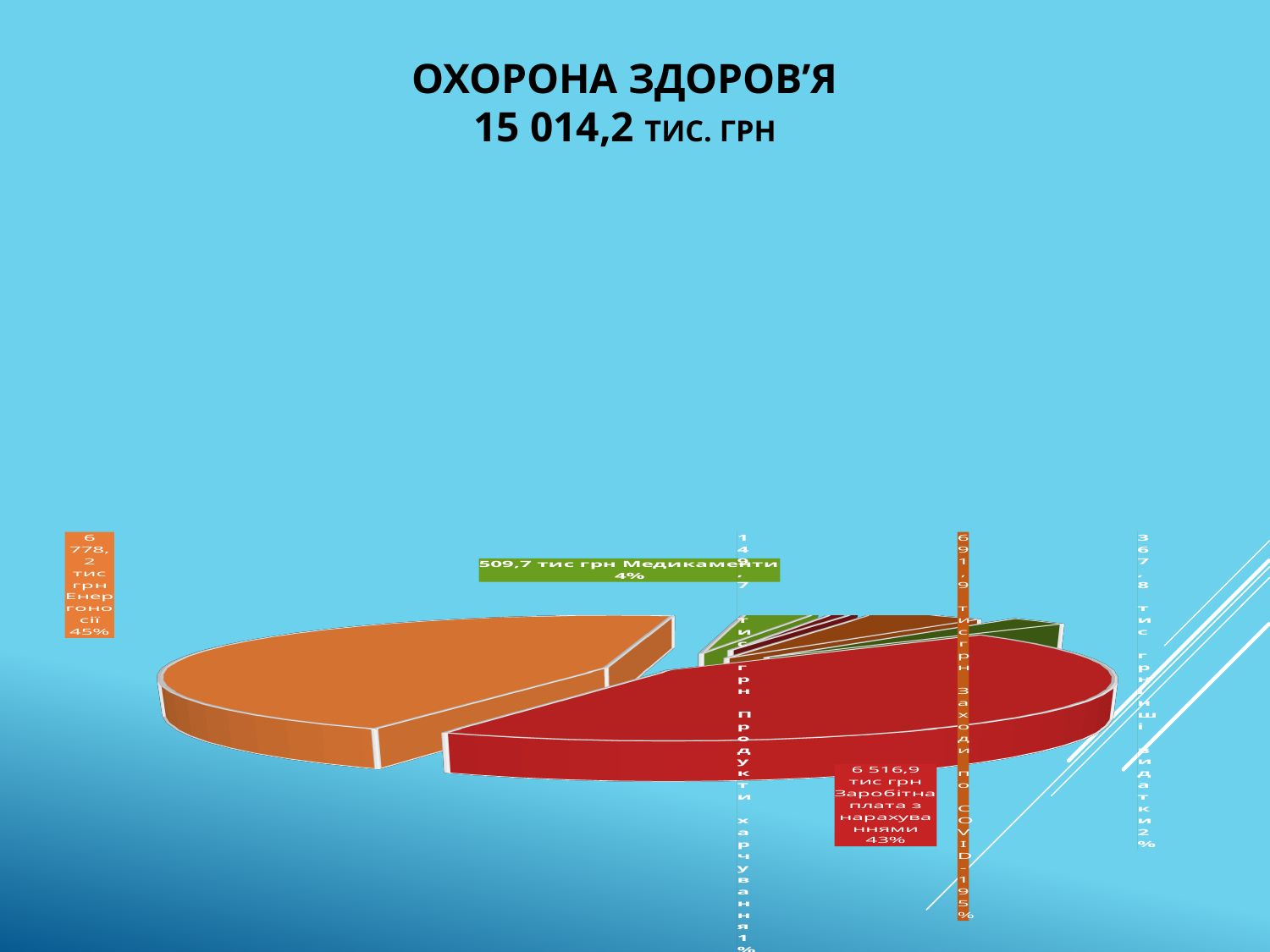
What share of the pie does Заробітна плата з нарахуваннями take? 43% Which is larger, Енергоносії or Заробітна плата з нарахуваннями? Енергоносії What share of the pie does Енергоносії take? 45% What is the value for Медикаменти? 509,7 тис грн What is the value for Енергоносії? 6 778,2 тис грн What is the total amount shown in the chart title for Охорона здоров'я? 15 014,2 тис. грн What is the value for Заробітна плата з нарахуваннями? 6 516,9 тис грн Which category has the largest slice of the pie? Енергоносії How many slices does the pie chart have? 6 What share of the pie does Медикаменти take? 4% What is the difference between Енергоносії and Заробітна плата з нарахуваннями? 261,3 тис грн What kind of chart is shown on the slide? pie chart